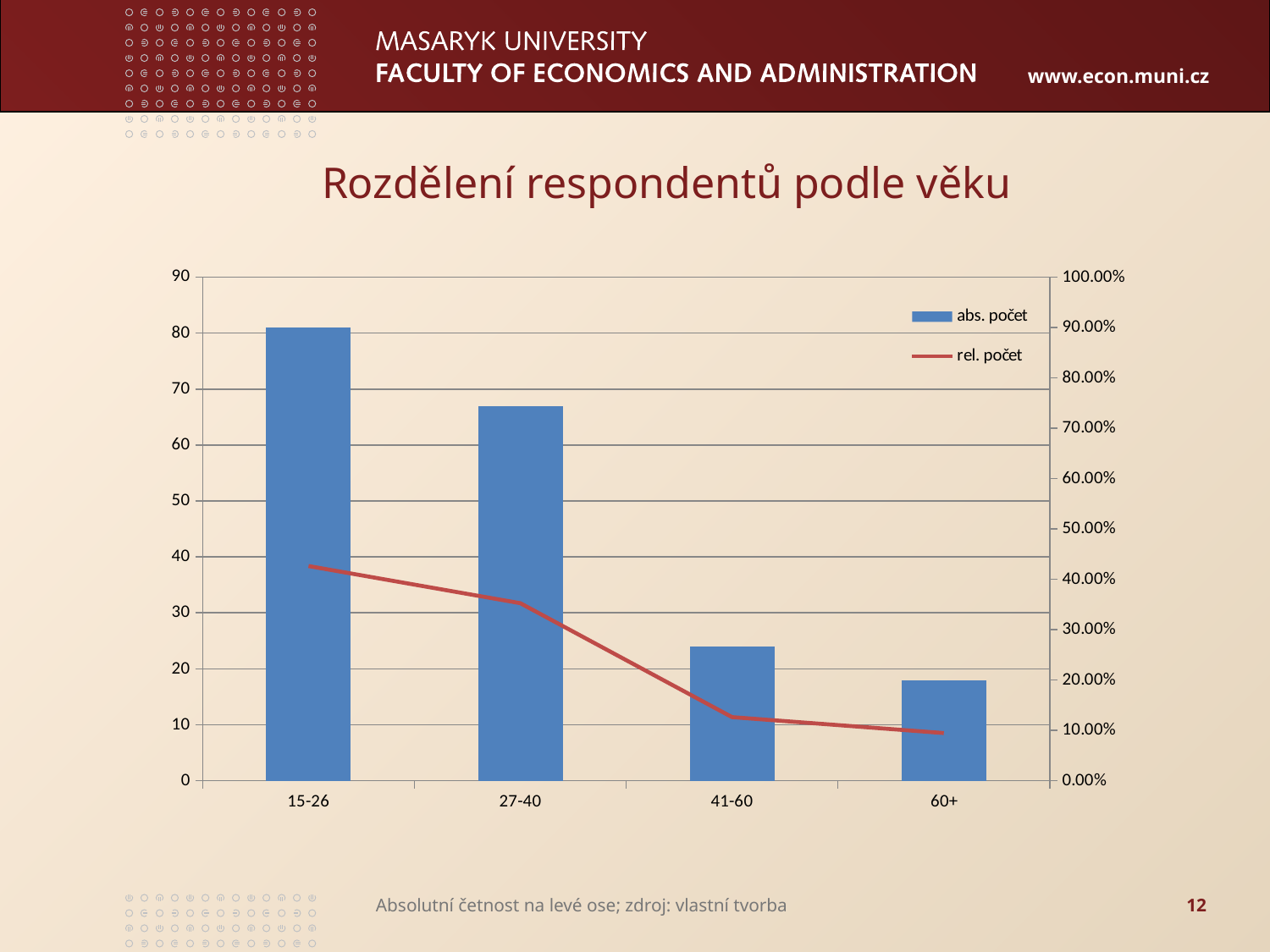
Is the abs. počet for the 27-40 group greater or less than 70? less Is the abs. počet for the 60+ group greater or less than 20? less Which age group has the highest abs. počet? 15-26 What is the title of the chart? Rozdělení respondentů podle věku Which age group has the lowest abs. počet? 60+ How many series does the legend list? 2 Which has a larger abs. počet, the 27-40 group or the 41-60 group? 27-40 Do the abs. počet values rise or fall as age increases along the x axis? fall Is the abs. počet for the 41-60 group greater or less than 20? greater How many age groups are shown on the x axis? 4